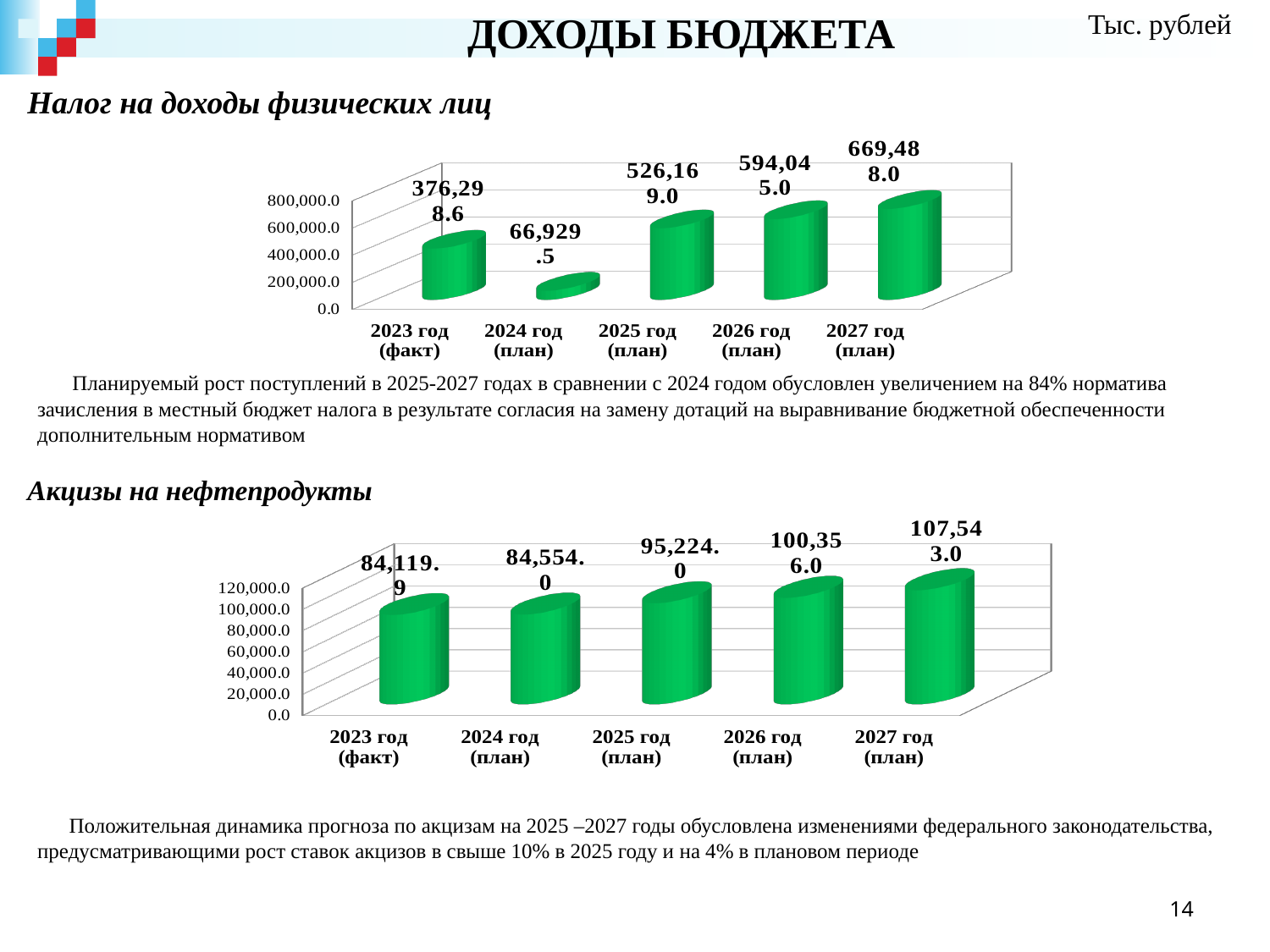
In the chart 'Акцизы на нефтепродукты', what is the value for 2023 год (факт)? 84,119.9 In the chart 'Акцизы на нефтепродукты', which year has the highest value? 2027 год (план) In the chart 'Налог на доходы физических лиц', how many years are shown on the x axis? 5 In the chart 'Налог на доходы физических лиц', what is the value for 2027 год (план)? 669,488.0 In the chart 'Налог на доходы физических лиц', what is the value for 2024 год (план)? 66,929.5 In the chart 'Налог на доходы физических лиц', which year has the lowest value? 2024 год (план) In the chart 'Акцизы на нефтепродукты', what is the difference between the values for 2027 год (план) and 2026 год (план)? 7,187.0 What kind of chart is the chart 'Акцизы на нефтепродукты'? bar chart In the chart 'Налог на доходы физических лиц', what is the difference between the values for 2027 год (план) and 2026 год (план)? 75,443.0 In the chart 'Акцизы на нефтепродукты', what is the value for 2025 год (план)? 95,224.0 In the chart 'Налог на доходы физических лиц', which year has the highest value? 2027 год (план) In the chart 'Акцизы на нефтепродукты', do the values rise or fall from 2023 to 2027? rise